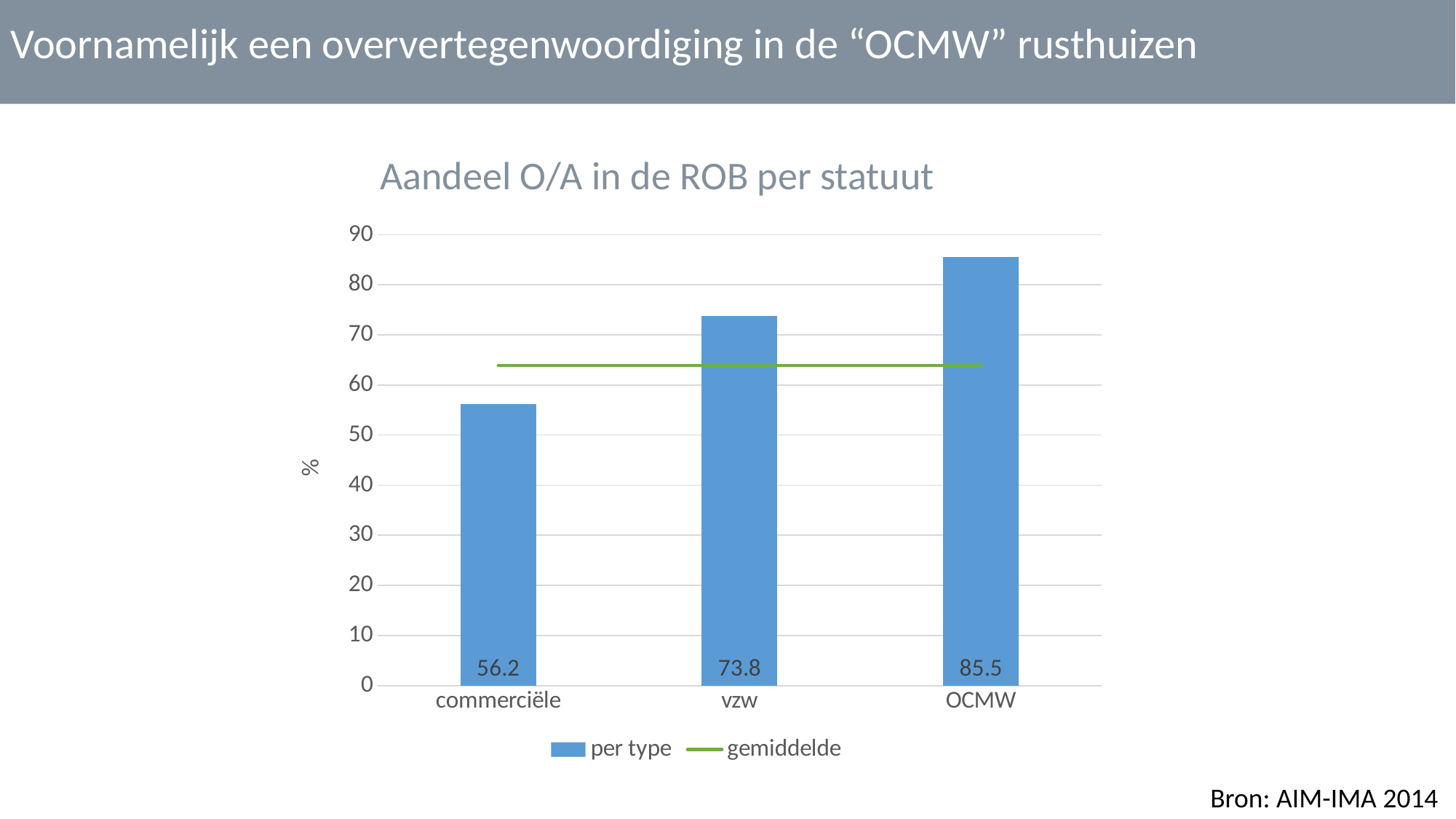
What is the value for commerciële? 56.2 What is the value for OCMW? 85.5 What is the value for vzw? 73.8 Is the gemiddelde line greater or less than 60? greater What is the title of the chart? Aandeel O/A in de ROB per statuut Which category has the lowest value? commerciële How many categories are shown on the x axis? 3 Which is larger, the value for vzw or the value for OCMW? OCMW Which category has the highest value? OCMW How many series does the legend list? 2 What is the difference between the values for OCMW and commerciële? 29.3 What is the difference between the values for vzw and commerciële? 17.6